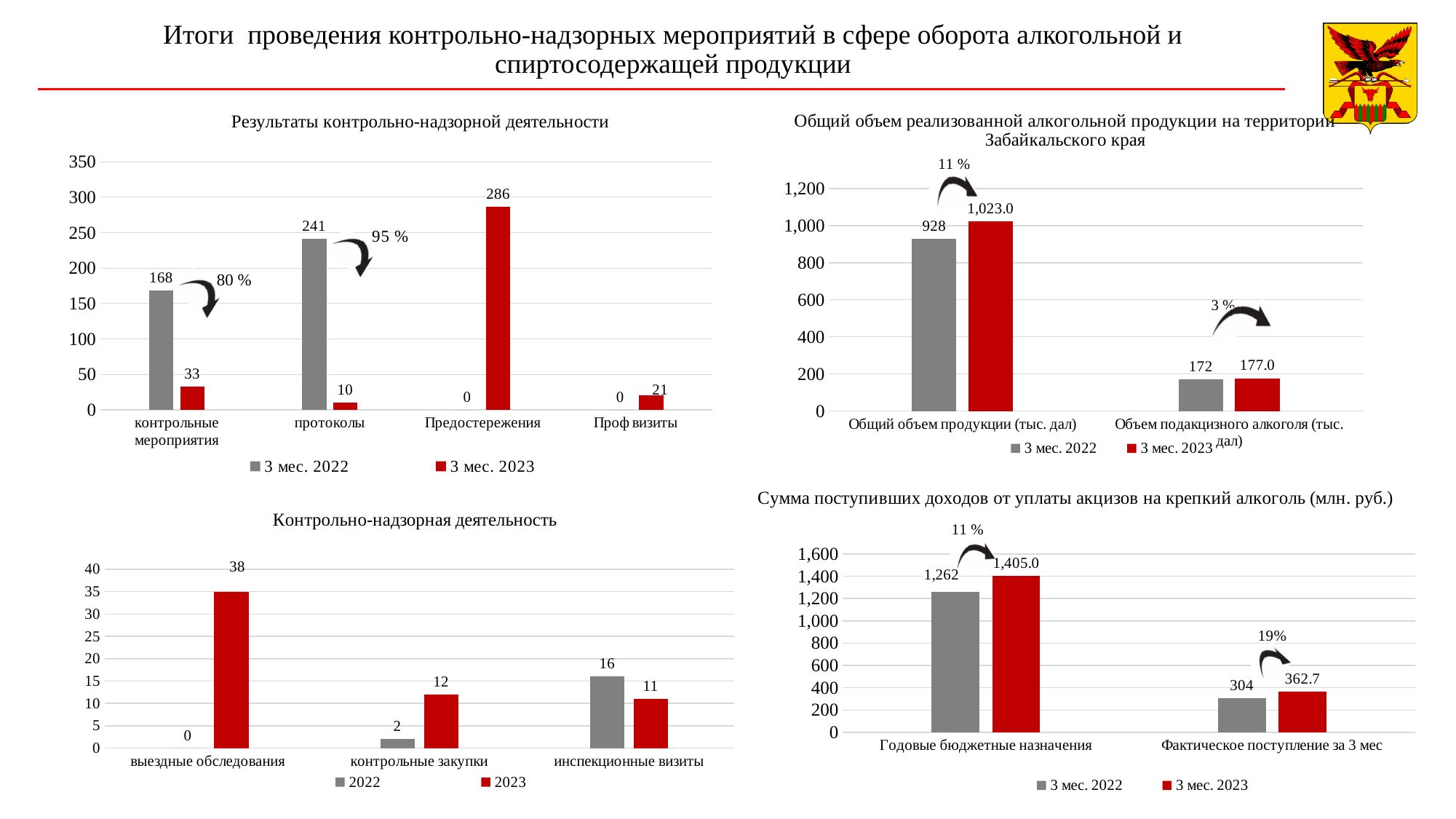
In the chart 'Результаты контрольно-надзорной деятельности', what is the value for 'протоколы' in the '3 мес. 2022' series? 241 In the chart 'Контрольно-надзорная деятельность', which category has the highest value in the 2022 series? инспекционные визиты In the chart 'Сумма поступивших доходов от уплаты акцизов на крепкий алкоголь (млн. руб.)', what is the '3 мес. 2023' value for 'Фактическое поступление за 3 мес'? 362.7 What type of chart is 'Контрольно-надзорная деятельность'? bar chart In the chart 'Результаты контрольно-надзорной деятельности', what is the difference between the '3 мес. 2022' and '3 мес. 2023' values for 'контрольные мероприятия'? 135 In the chart 'Общий объем реализованной алкогольной продукции на территории Забайкальского края', which is larger for 'Объем подакцизного алкоголя': the '3 мес. 2022' value or the '3 мес. 2023' value? 3 мес. 2023 In the chart 'Общий объем реализованной алкогольной продукции на территории Забайкальского края', what is the '3 мес. 2023' value for 'Общий объем продукции (тыс. дал)'? 1,023.0 In the chart 'Сумма поступивших доходов от уплаты акцизов на крепкий алкоголь (млн. руб.)', what is the difference between the '3 мес. 2023' and '3 мес. 2022' values for 'Годовые бюджетные назначения'? 143 How many series does the legend list in the chart 'Общий объем реализованной алкогольной продукции на территории Забайкальского края'? 2 How many categories are shown on the x axis of the chart 'Результаты контрольно-надзорной деятельности'? 4 In the chart 'Контрольно-надзорная деятельность', what is the 2023 value for 'выездные обследования'? 38 In the chart 'Результаты контрольно-надзорной деятельности', which category has the highest value in the '3 мес. 2023' series? Предостережения